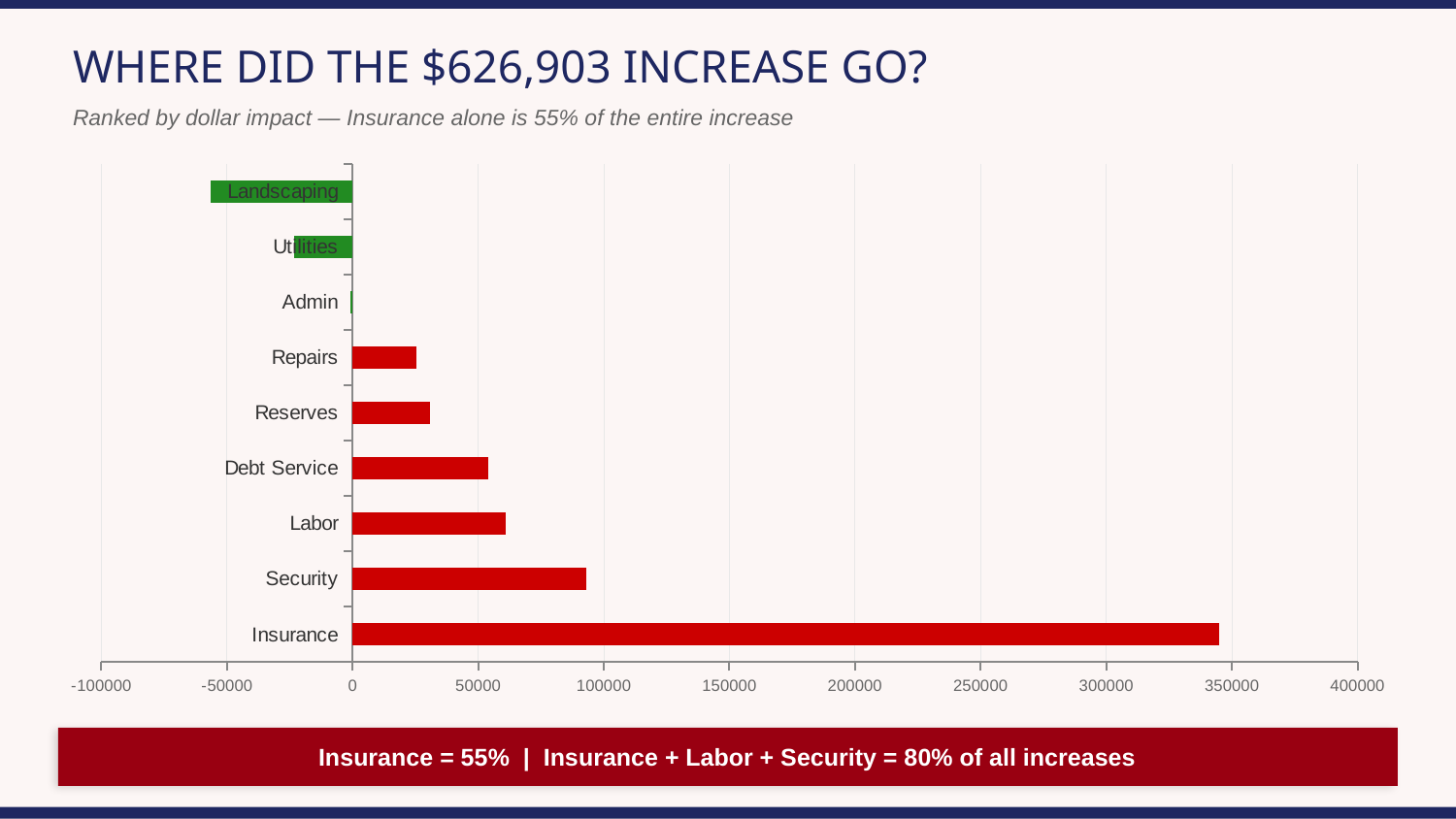
How many categories are plotted in the chart? 9 How many categories in the chart have negative values? 3 Which category has the highest value in the chart? Insurance Which has the larger value, Security or Labor? Security What kind of chart is shown on the slide? bar chart What is the title of the slide containing the chart? WHERE DID THE $626,903 INCREASE GO? Is the value for Security greater or less than 100000? less Is the value for Repairs greater or less than 50000? less Which category has the lowest value in the chart? Landscaping Is the value for Labor greater or less than 50000? greater